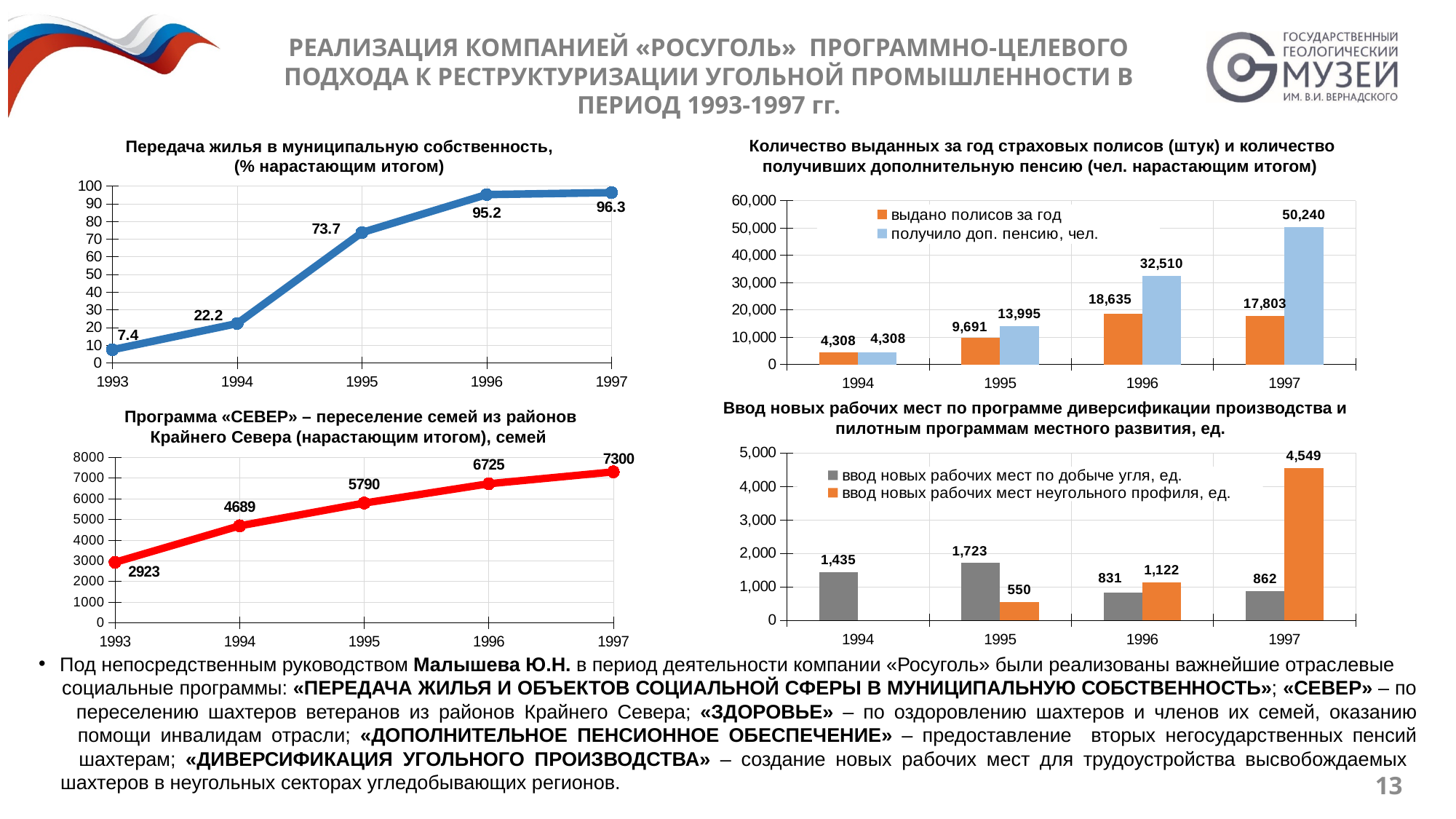
In the top-left chart 'Передача жилья в муниципальную собственность', what kind of chart is shown? line chart In the top-right chart on insurance policies and additional pensions, how many series does the legend list? 2 In the bottom-right chart on new jobs, what is the value of 'ввод новых рабочих мест неугольного профиля, ед.' for 1997? 4,549 In the bottom-left chart 'Программа «СЕВЕР»', what is the value for 1994? 4689 In the top-left chart 'Передача жилья в муниципальную собственность', what is the value for 1995? 73.7 In the top-right chart on insurance policies and additional pensions, what is the difference between 'получило доп. пенсию, чел.' and 'выдано полисов за год' in 1996? 13,875 In the bottom-left chart 'Программа «СЕВЕР»', what is the difference between the 1997 and 1993 values? 4377 In the bottom-left chart 'Программа «СЕВЕР»', how many data points are plotted? 5 In the top-right chart on insurance policies and additional pensions, what is the value of 'получило доп. пенсию, чел.' for 1997? 50,240 In the bottom-right chart on new jobs, which is larger in 1996: 'ввод новых рабочих мест по добыче угля, ед.' or 'ввод новых рабочих мест неугольного профиля, ед.'? ввод новых рабочих мест неугольного профиля, ед. In the top-right chart on insurance policies and additional pensions, which year has the highest value of 'выдано полисов за год'? 1996 In the top-left chart 'Передача жилья в муниципальную собственность', do the values rise or fall from 1993 to 1997? rise